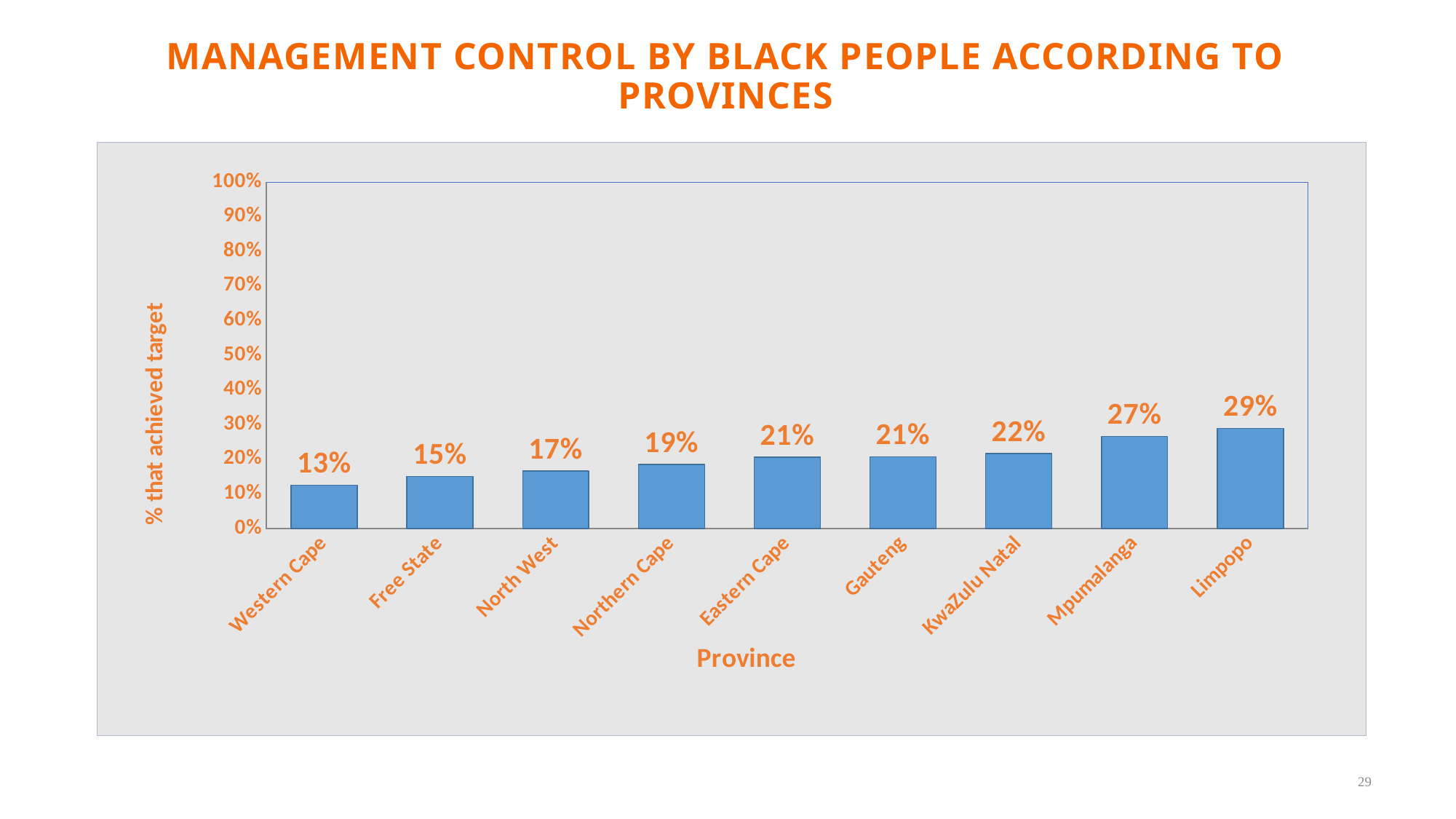
How many provinces are shown on the chart? 9 What is the difference between the values for Limpopo and Western Cape? 16% Which has a higher value, North West or Northern Cape? Northern Cape What kind of chart is shown on the slide? Bar chart What percentage of entities achieved the management control target in Gauteng? 21% What is the label of the y axis? % that achieved target What is the difference between the values for KwaZulu Natal and Free State? 7% Do the values rise or fall from Western Cape to Limpopo along the x axis? Rise Which province has the lowest percentage that achieved the target? Western Cape Which province has the highest percentage that achieved the target? Limpopo Is the value for Limpopo greater or less than 30%? less What is the value shown for Mpumalanga? 27%